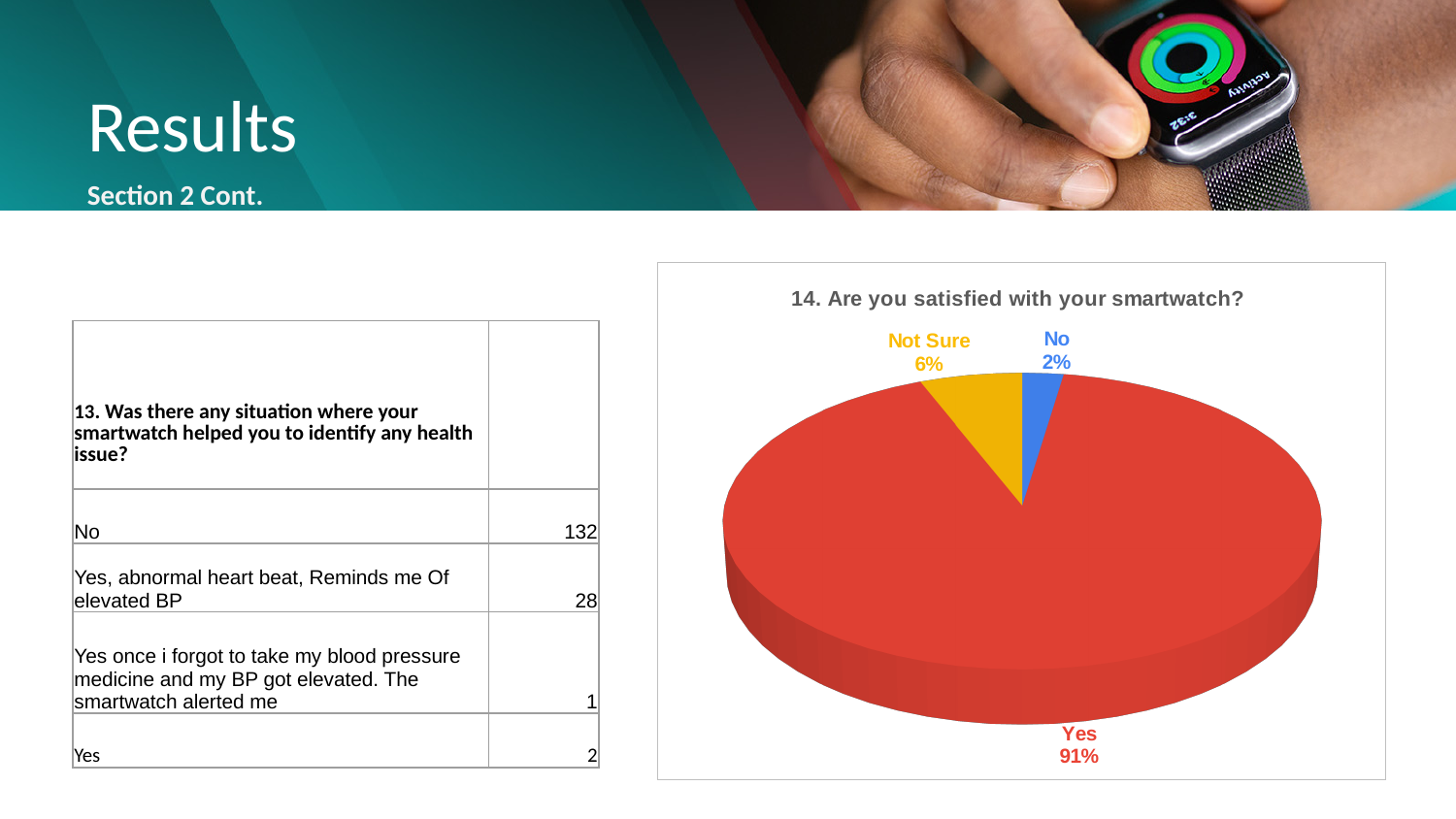
How many slices does the pie chart have? 3 What is the difference in percentage points between the "Not Sure" and "No" slices? 4 What share of the pie does the "Not Sure" slice represent? 6% What colour is the "Yes" slice in the pie chart? Red What is the title of the pie chart? 14. Are you satisfied with your smartwatch? Which slice of the pie chart is the largest? Yes What kind of chart is shown on the slide? Pie chart What share of the pie does the "No" slice represent? 2% What share of the pie does the "Yes" slice represent? 91% Which slice of the pie chart is the smallest? No Which is larger, the "Not Sure" slice or the "No" slice? Not Sure What is the difference in percentage points between the "Yes" and "Not Sure" slices? 85